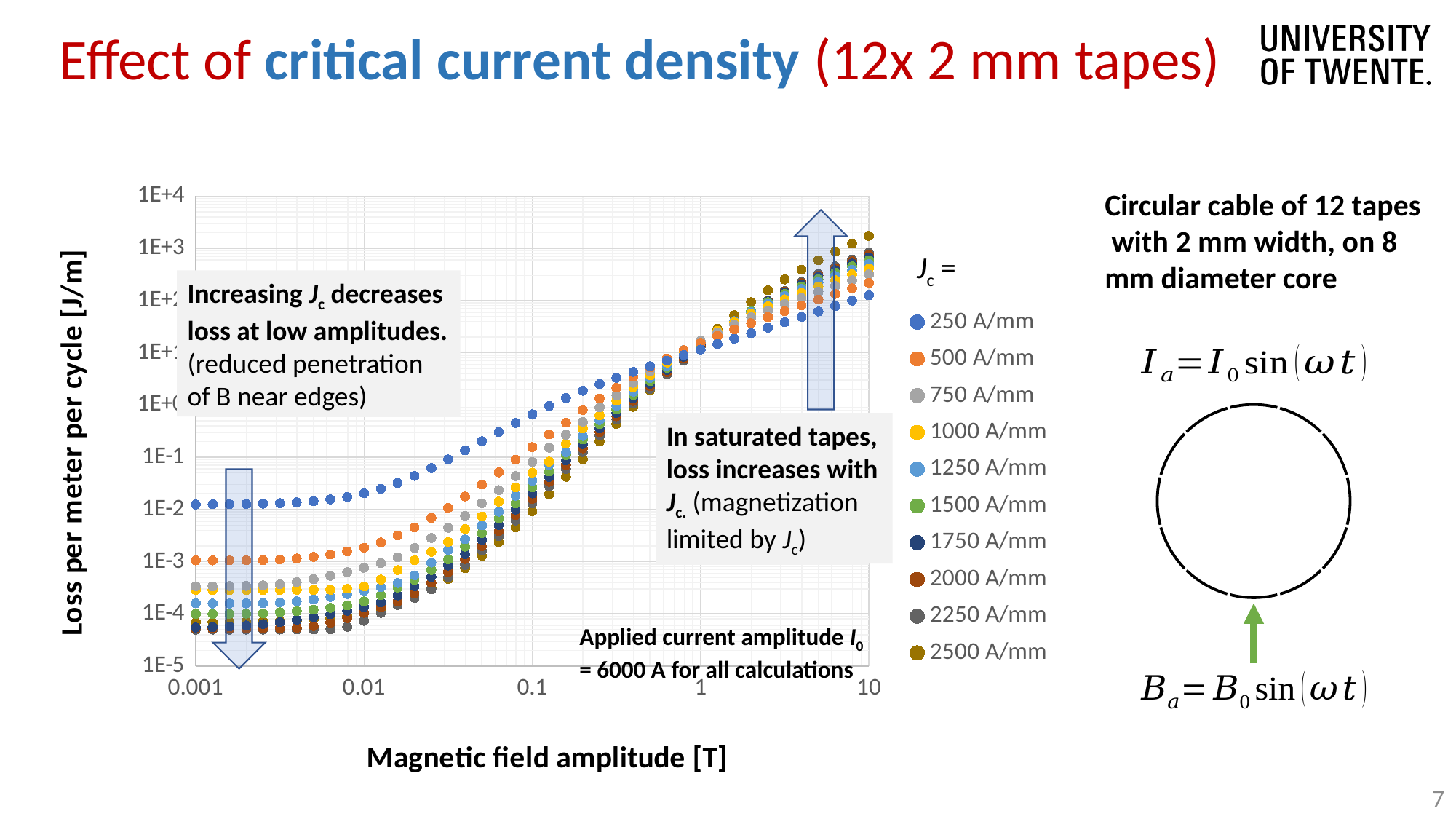
Which series has the highest loss at a magnetic field amplitude of 10 T? 2500 A/mm At 10 T, which series has the larger loss: 250 A/mm or 2500 A/mm? 2500 A/mm Is the loss for the 250 A/mm series at 10 T greater or less than 1E+3 J/m? less What kind of chart is shown on the slide? scatter chart Do the loss values rise or fall as the magnetic field amplitude increases along the x axis? rise Is the loss for the 2500 A/mm series at 10 T greater or less than 1E+3 J/m? greater At 0.001 T, which series has the larger loss: 250 A/mm or 2500 A/mm? 250 A/mm What is the title of the y axis of the chart? Loss per meter per cycle [J/m] Which series has the highest loss at a magnetic field amplitude of 0.001 T? 250 A/mm How many series does the legend list? 10 Is the loss for the 250 A/mm series at 0.001 T greater or less than 1E-3 J/m? greater What is the title of the x axis of the chart? Magnetic field amplitude [T]